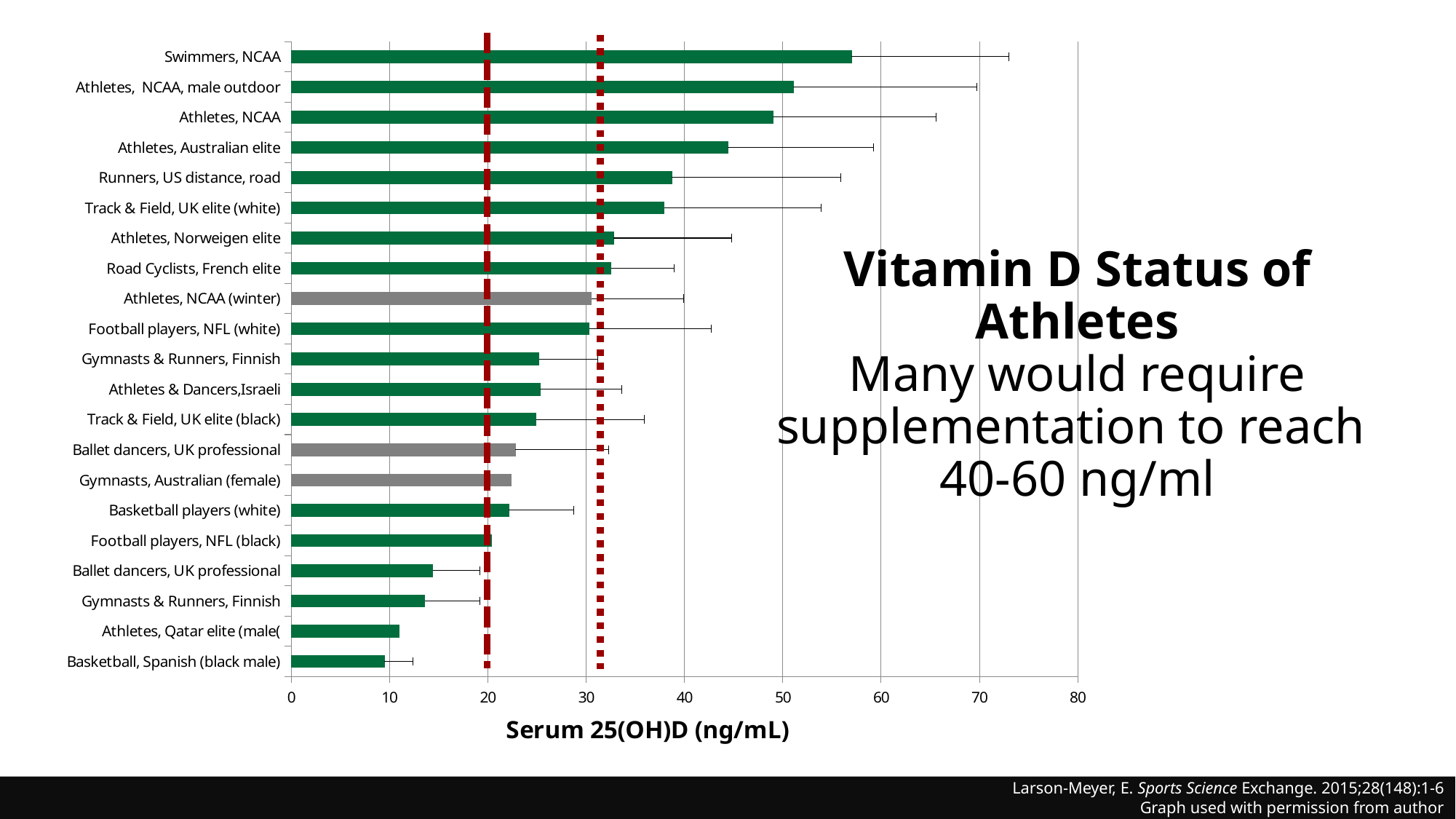
What kind of chart is shown on the slide? bar chart Do the bar lengths increase or decrease going from the top of the chart to the bottom? decrease Is the value for Swimmers, NCAA greater or less than 50? greater Which athlete group has the highest serum 25(OH)D value? Swimmers, NCAA Is the value for Track & Field, UK elite (white) greater or less than 30? greater What is the title of the horizontal axis of the chart? Serum 25(OH)D (ng/mL) How many athlete groups (bars) are plotted in the chart? 21 Is the value for Athletes, Australian elite greater or less than 40? greater Which is larger, the value for Road Cyclists, French elite or the value for Basketball players (white)? Road Cyclists, French elite Which is larger, the value for Swimmers, NCAA or the value for Athletes, Australian elite? Swimmers, NCAA